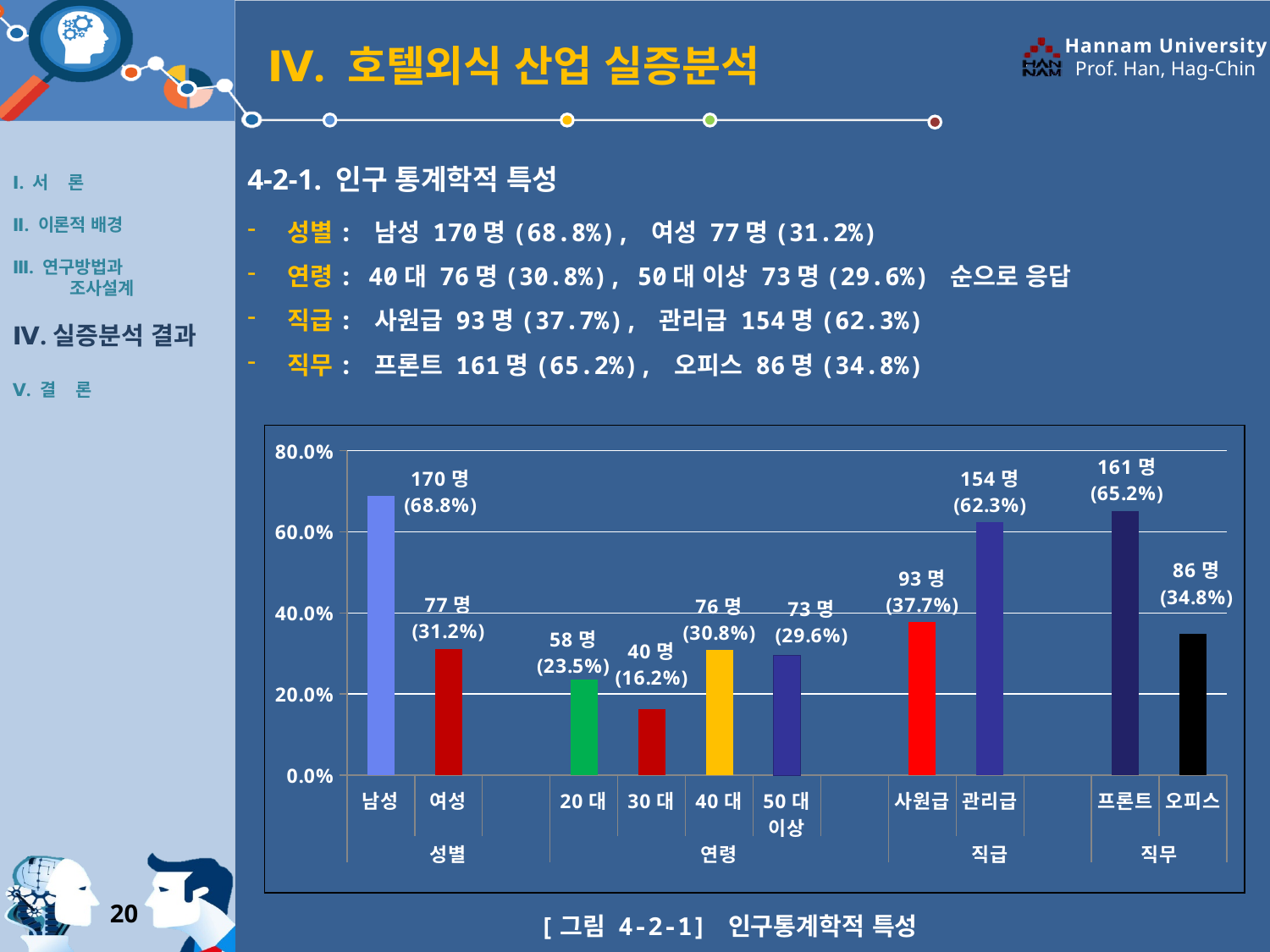
Within the 연령 group, which category has the highest bar? 40 대 Which category has the highest bar in the chart? 남성 Which bar is taller, 사원급 or 관리급? 관리급 What type of chart is shown on the slide? bar chart Which category has the lowest bar in the chart? 30 대 What percentage is shown for 30 대 in the chart? 16.2% What percentage is shown for 남성 in the chart? 68.8% How many bars are plotted in the chart? 10 What is the difference in percentage points between 프론트 (65.2%) and 오피스 (34.8%)? 30.4 How many people (명) are shown for 관리급 in the chart? 154 명 Is the value for 50 대 이상 greater or less than 40.0%? less How many people (명) are shown for 여성 in the chart? 77 명